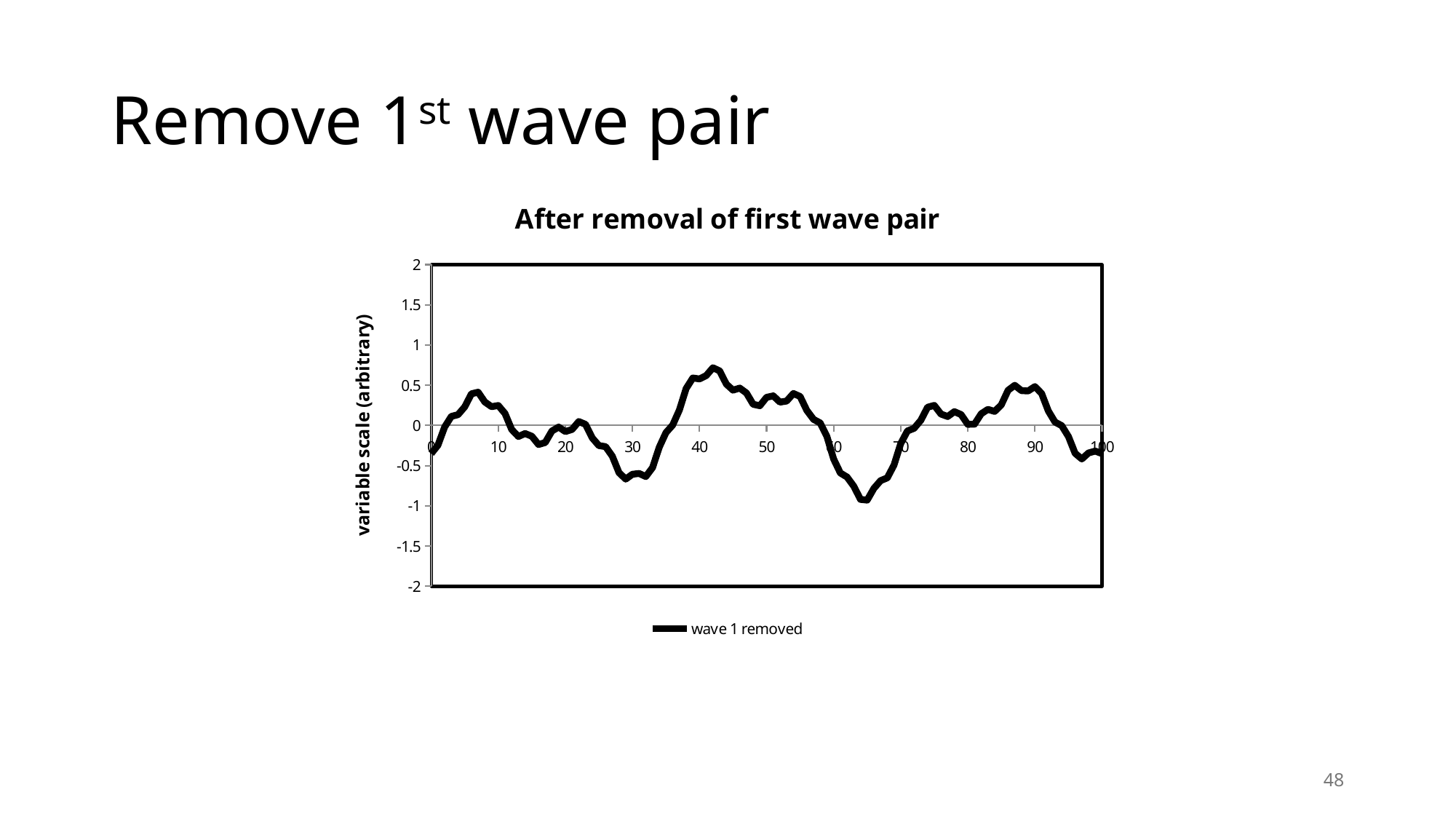
Is the value of the line at x = 42 greater or less than 0.5? greater Is the value of the line at x = 100 greater or less than 0? less Is the value of the line at x = 65 greater or less than -0.5? less How many series does the legend list? 1 Does the line rise or fall between x = 55 and x = 65? fall Does the line rise or fall between x = 30 and x = 42? rise What kind of chart is shown on the slide? line chart What is the name of the series shown in the legend? wave 1 removed What is the title of the chart? After removal of first wave pair